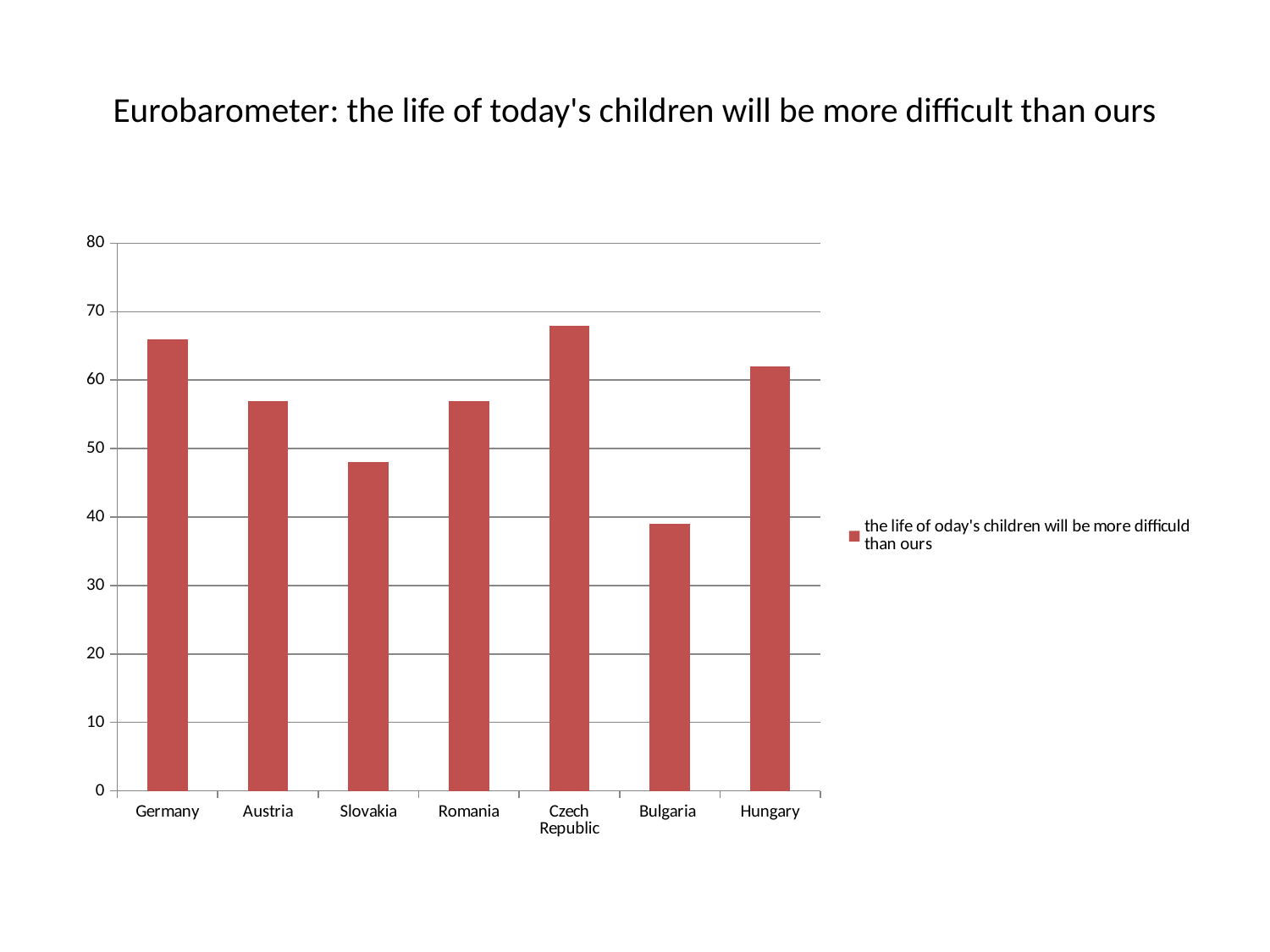
Which is larger, the value for Germany or the value for Austria? Germany Which country has the lowest bar in the chart? Bulgaria Is the value for Austria greater or less than 50? greater What kind of chart is shown on the slide? bar chart Is the value for Slovakia greater or less than 50? less Which is larger, the value for Hungary or the value for Slovakia? Hungary How many countries are shown on the x axis of the chart? 7 Is the value for Germany greater or less than 60? greater How many series does the legend list? 1 What is the title of the slide? Eurobarometer: the life of today's children will be more difficult than ours